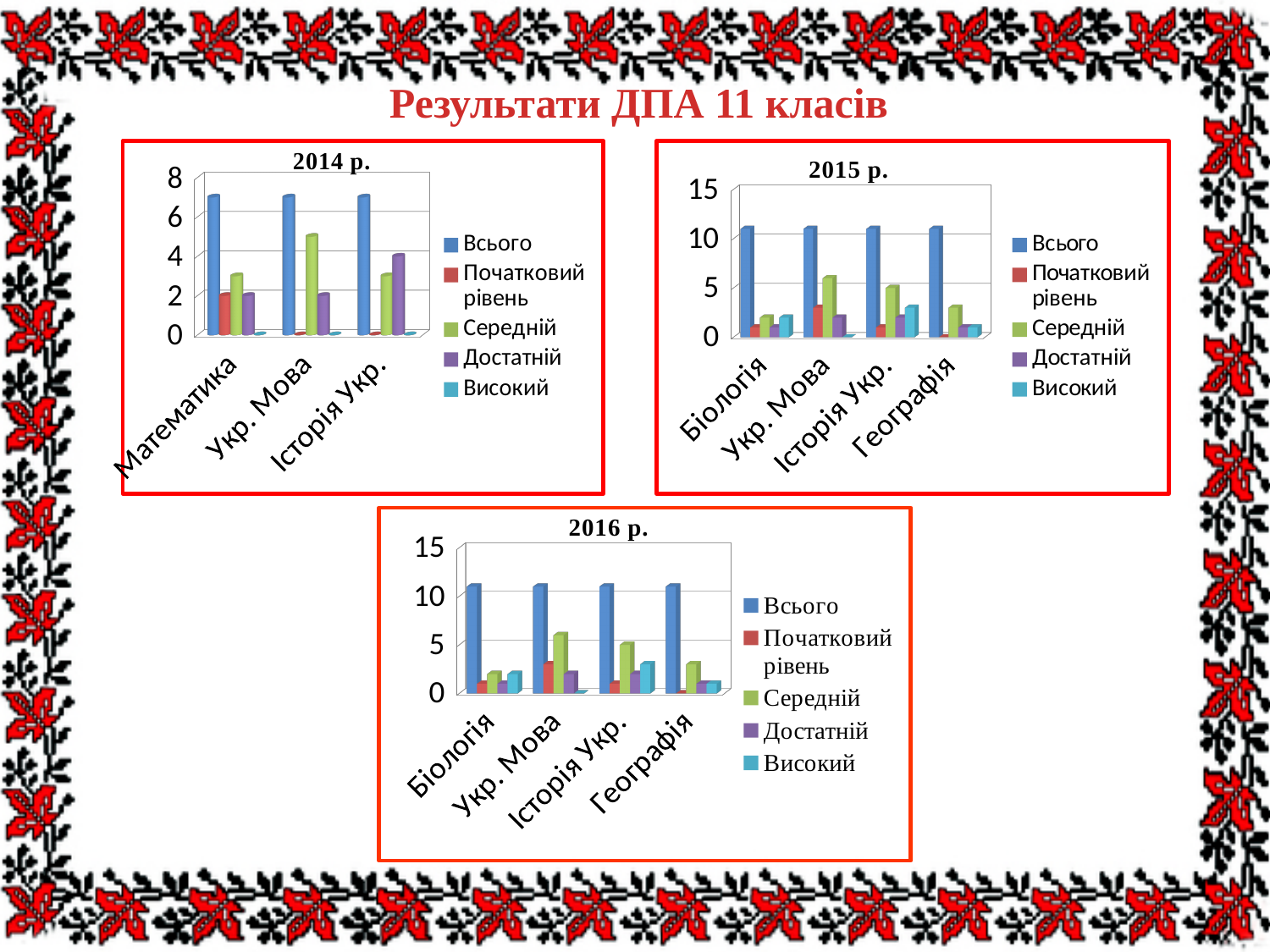
What kind of chart is the "2014 р." chart? bar chart How many categories are shown on the x axis of the "2014 р." chart? 3 How many series does the legend of the "2016 р." chart list? 5 In the "2016 р." chart, which is larger for Біологія: Всього or Середній? Всього How many categories are shown on the x axis of the "2015 р." chart? 4 In the "2014 р." chart, is the value of Всього for Математика greater or less than 6? greater In the "2015 р." chart, is the value of Середній for Географія greater or less than 5? less In the "2014 р." chart, which is larger: the Достатній value for Історія Укр. or for Математика? Історія Укр. What is the title of the chart at the bottom of the slide? 2016 р. In the "2016 р." chart, is the value of Середній for Укр. Мова greater or less than 5? greater In the "2014 р." chart, which category has the highest value for Середній? Укр. Мова